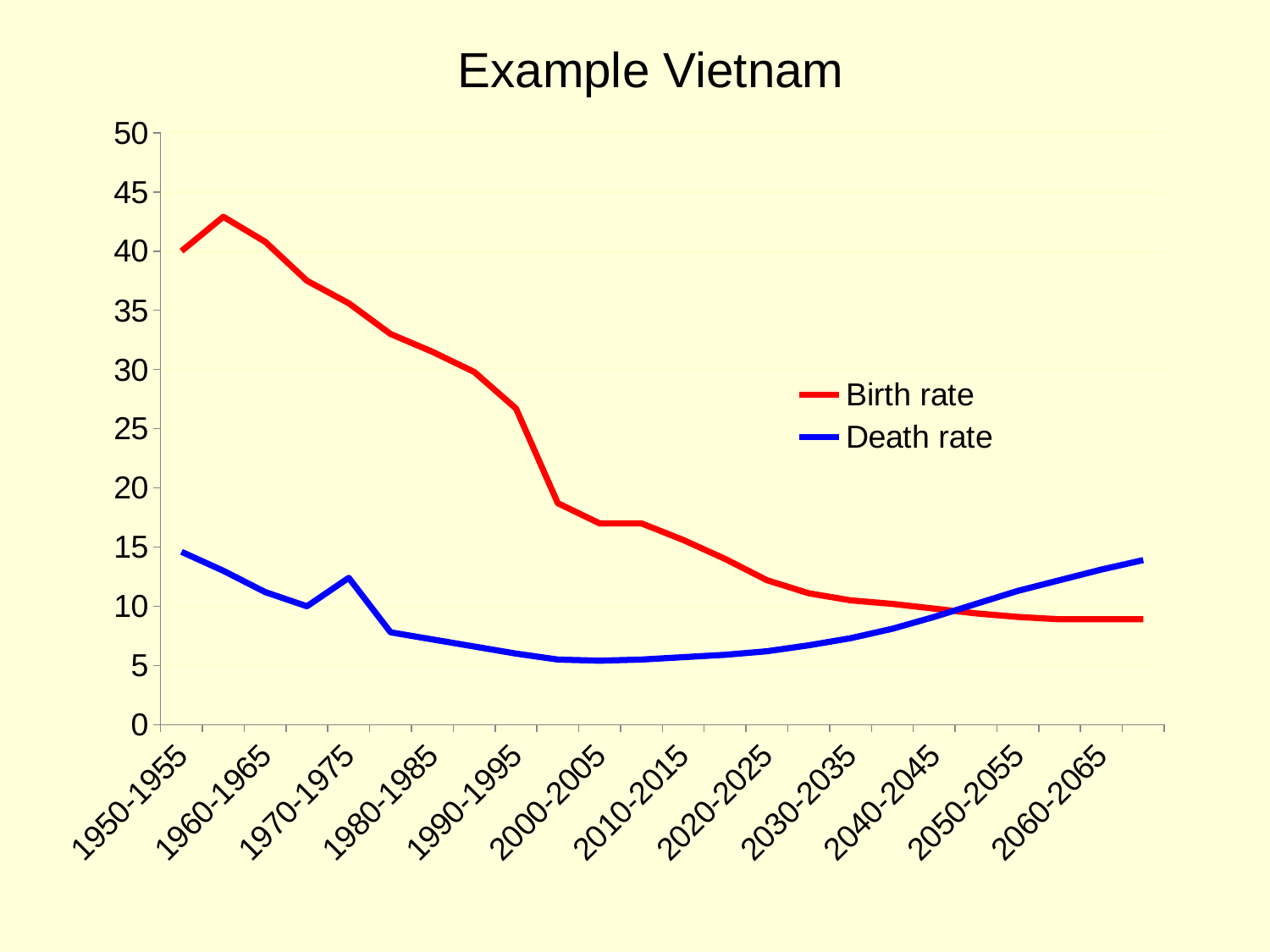
Is the Death rate for 2000-2005 greater or less than 10? less How many series does the legend list? 2 What kind of chart is shown on the slide? line chart Which colour is used for the Death rate line? blue In 2060-2065, which is larger, the Birth rate or the Death rate? Death rate Is the Birth rate for 2060-2065 greater or less than 10? less In 1950-1955, which is larger, the Birth rate or the Death rate? Birth rate What is the title of the chart? Example Vietnam Does the Birth rate generally rise or fall from 1950-1955 to 2060-2065? fall Is the Birth rate for 2000-2005 greater or less than 20? less